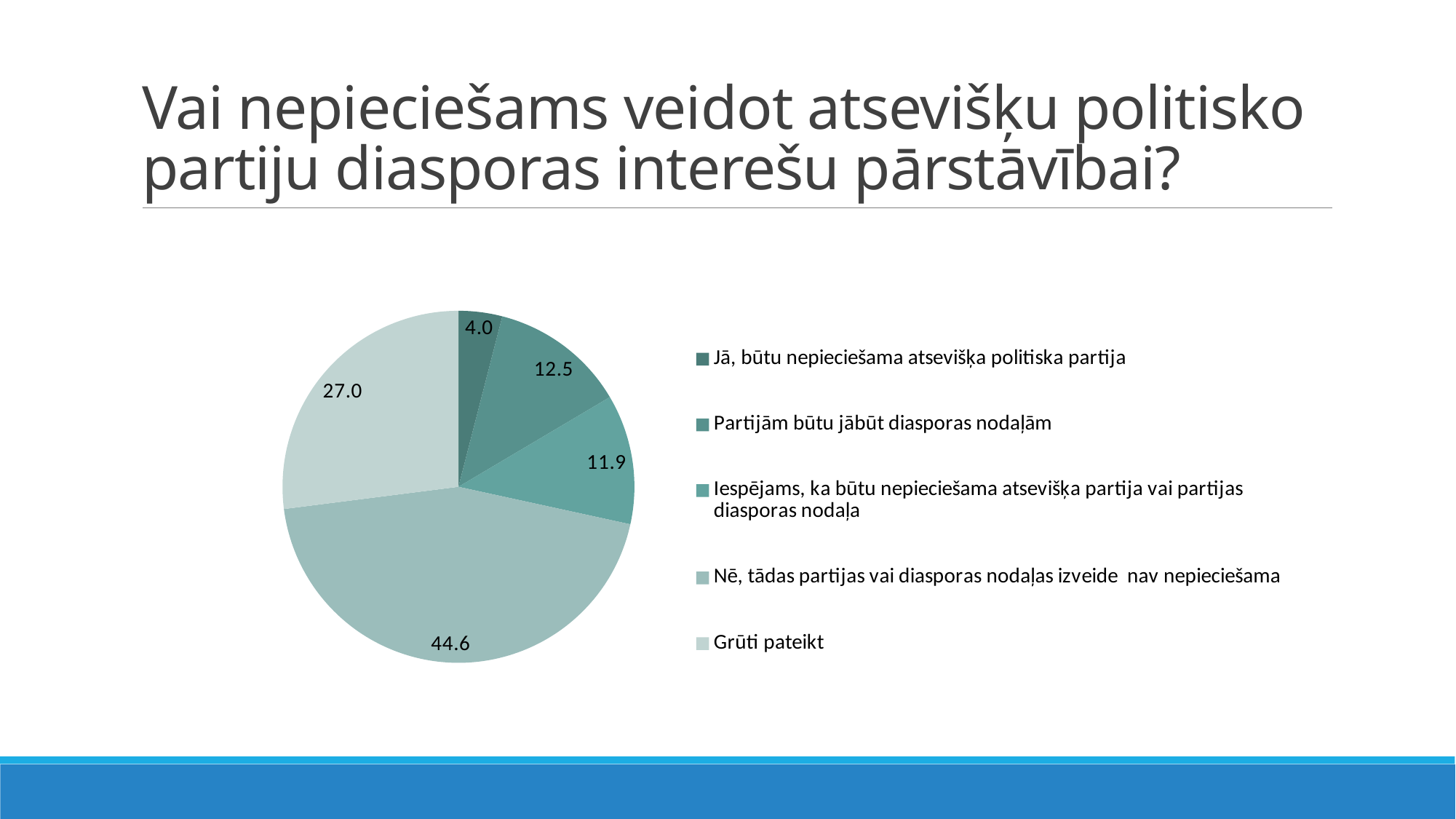
What is the value for "Nē, tādas partijas vai diasporas nodaļas izveide nav nepieciešama"? 44.6 What type of chart is shown on the slide? pie chart What is the value for "Jā, būtu nepieciešama atsevišķa politiska partija"? 4.0 Which category has the smallest slice of the pie? Jā, būtu nepieciešama atsevišķa politiska partija What is the title of the slide containing the pie chart? Vai nepieciešams veidot atsevišķu politisko partiju diasporas interešu pārstāvībai? Which is larger: the value for "Partijām būtu jābūt diasporas nodaļām" or the value for "Iespējams, ka būtu nepieciešama atsevišķa partija vai partijas diasporas nodaļa"? Partijām būtu jābūt diasporas nodaļām What is the value for "Partijām būtu jābūt diasporas nodaļām"? 12.5 What is the value for "Grūti pateikt"? 27.0 How many slices does the pie chart have? 5 Which category has the largest slice of the pie? Nē, tādas partijas vai diasporas nodaļas izveide nav nepieciešama What is the difference between the values for "Nē, tādas partijas vai diasporas nodaļas izveide nav nepieciešama" and "Grūti pateikt"? 17.6 How many entries does the legend list? 5